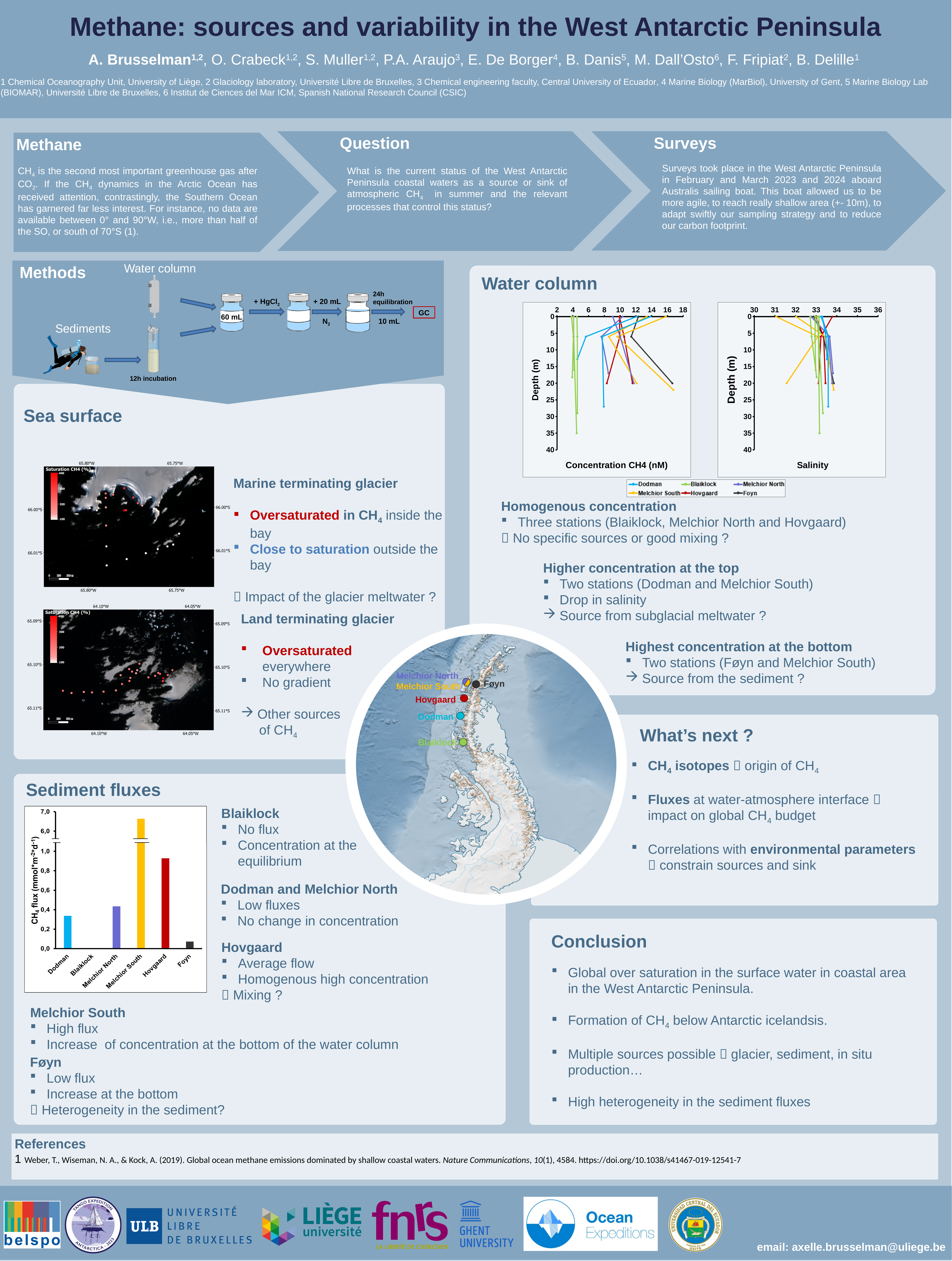
In the Sediment fluxes bar chart, is the CH4 flux for Melchior South greater or less than 6,0? greater In the Sediment fluxes bar chart, which has the larger CH4 flux, Dodman or Føyn? Dodman What is the y-axis label of the Sediment fluxes bar chart? CH4 flux (mmol*m-2*d-1) What kind of chart is the Concentration CH4 (nM) chart in the Water column section? line chart How many stations does the legend of the Water column charts list? 6 In the Sediment fluxes bar chart, is the CH4 flux for Dodman greater or less than 0,4? less What kind of chart is the Sediment fluxes chart? bar chart In the Sediment fluxes bar chart, which has the larger CH4 flux, Hovgaard or Melchior North? Hovgaard In the Sediment fluxes bar chart, which station shows no bar (zero flux)? Blaiklock How many stations are shown on the x axis of the Sediment fluxes bar chart? 6 In the Sediment fluxes bar chart, is the CH4 flux for Hovgaard greater or less than 0,8? greater In the Sediment fluxes bar chart, which station has the highest CH4 flux? Melchior South